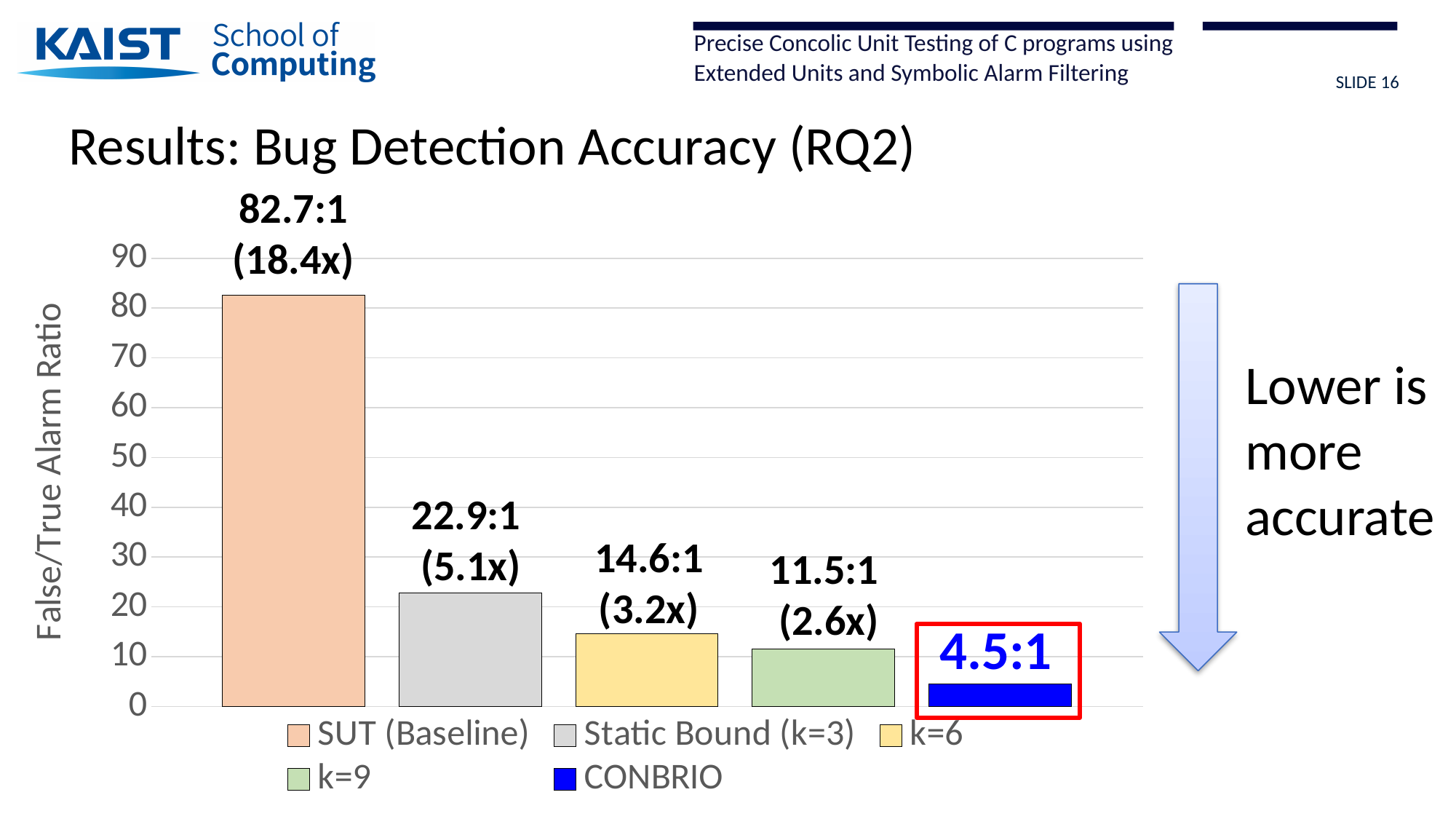
What is the label of the vertical axis? False/True Alarm Ratio How many series does the legend list? 5 What is the false/true alarm ratio for CONBRIO? 4.5:1 Which series has the highest false/true alarm ratio? SUT (Baseline) What is the false/true alarm ratio for k=9? 11.5:1 What is the false/true alarm ratio for SUT (Baseline)? 82.7:1 Which has a larger false/true alarm ratio, k=6 or k=9? k=6 What kind of chart is shown on the slide? Bar chart Which series has the lowest false/true alarm ratio? CONBRIO What is the false/true alarm ratio for Static Bound (k=3)? 22.9:1 By how much does the false/true alarm ratio of SUT (Baseline) exceed that of CONBRIO? 78.2 Is the value for Static Bound (k=3) greater or less than 20? greater